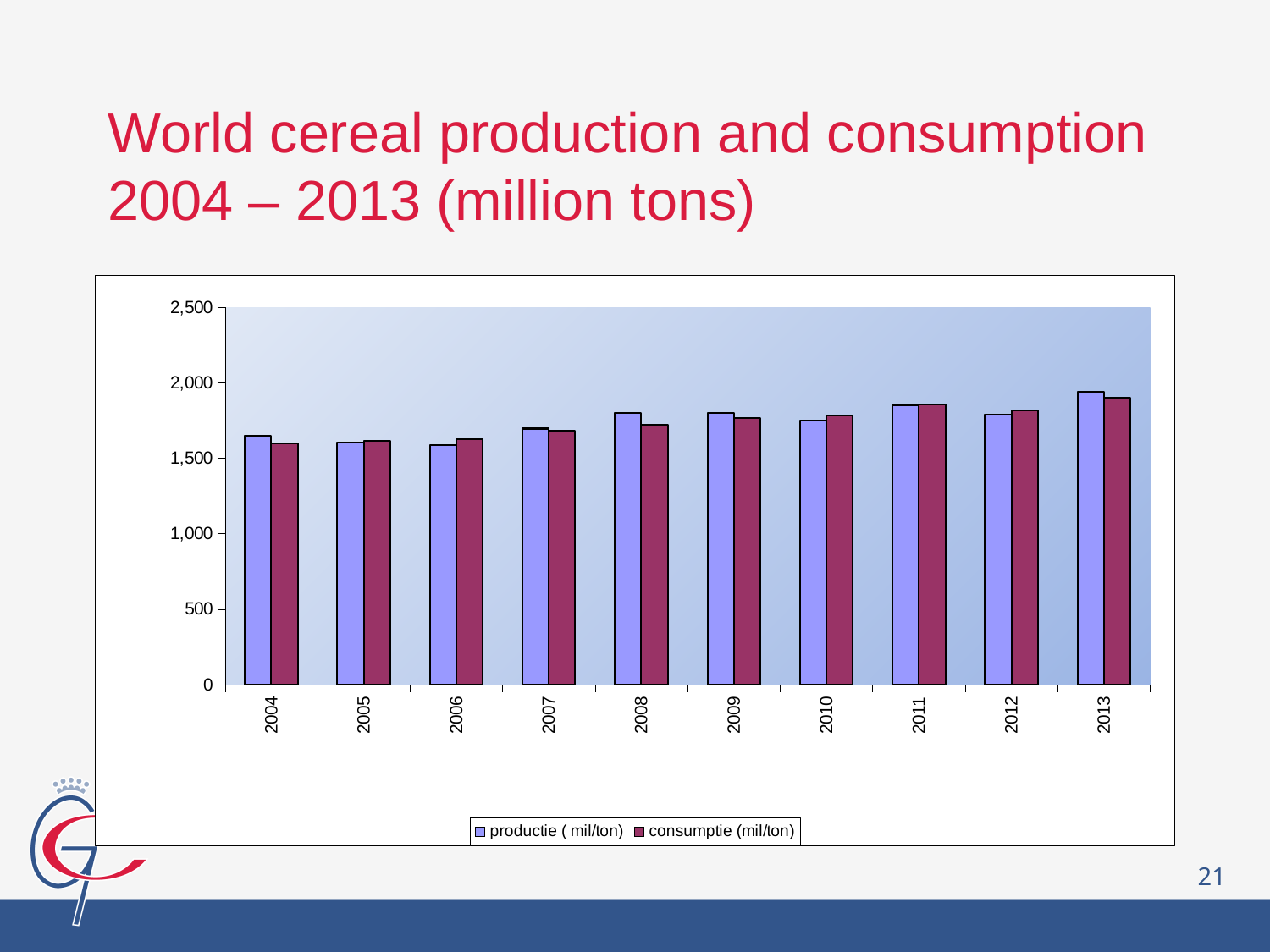
How many series does the legend list? 2 Is the consumption value for 2013 greater or less than 2,000? less Is the production value for 2004 greater or less than 1,500? greater What are the two legend entries of the chart? productie ( mil/ton) and consumptie (mil/ton) Which year has the highest consumption (consumptie) value? 2013 Which year has the highest production (productie) value? 2013 Do the consumption values generally rise or fall from 2004 to 2013? rise How many years are shown on the x axis? 10 In 2010, which is larger: production or consumption? consumption Is the production value for 2006 greater or less than 2,000? less In 2013, which is larger: production or consumption? production What kind of chart is shown on the slide? bar chart